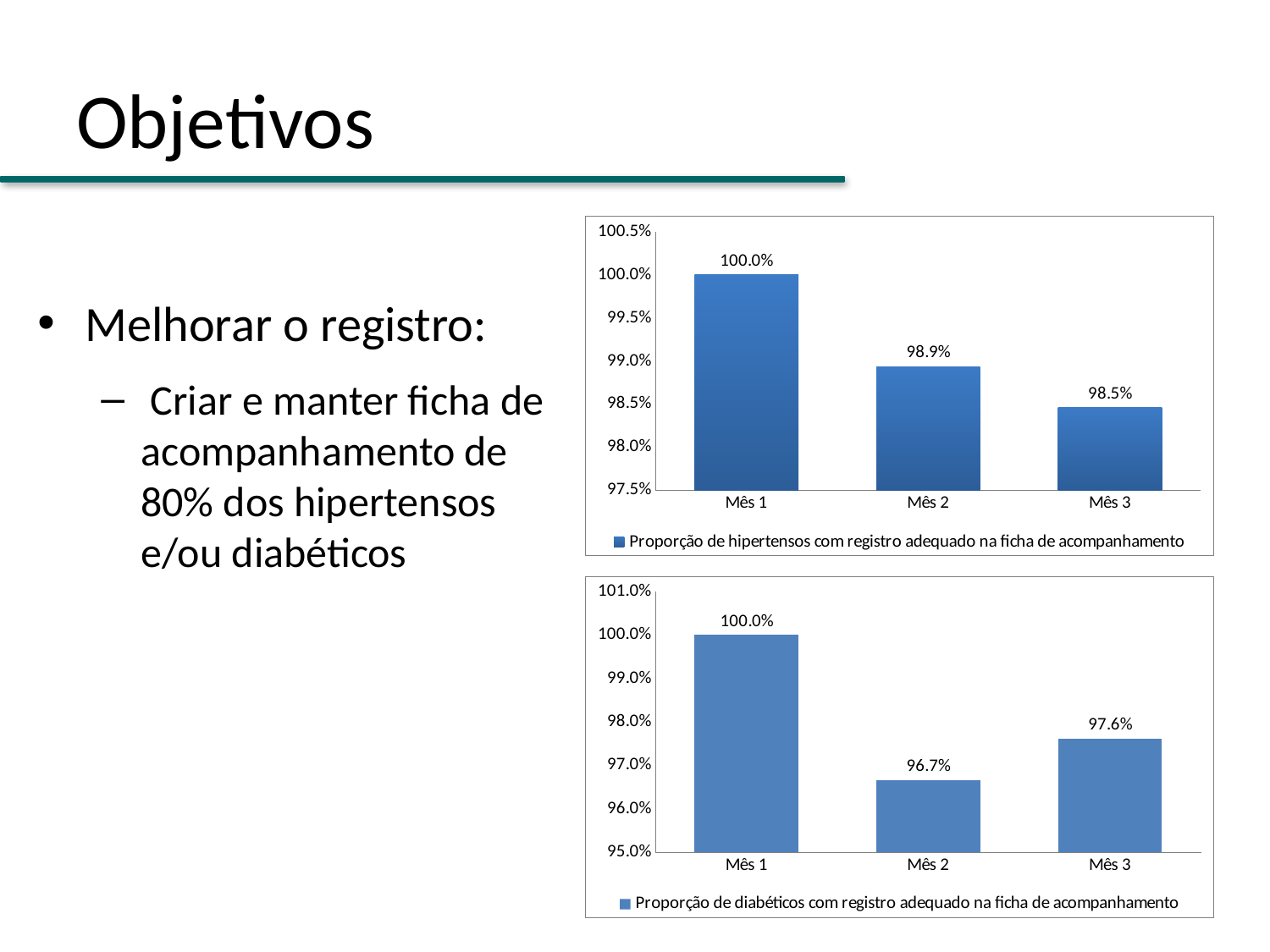
In the bottom chart (diabéticos), what is the difference between Mês 3 and Mês 2? 0.9% In the bottom chart (diabéticos), what is the value for Mês 2? 96.7% In the bottom chart (diabéticos), which is larger, Mês 2 or Mês 3? Mês 3 In the bottom chart (diabéticos), what is the value for Mês 3? 97.6% In the top chart (hipertensos), what is the value for Mês 3? 98.5% In the top chart (hipertensos), which month has the lowest value? Mês 3 In the bottom chart (diabéticos), which month has the highest value? Mês 1 What kind of chart is the bottom chart (diabéticos)? Bar chart In the top chart (hipertensos), what is the value for Mês 2? 98.9% How many months are shown on the x axis of the top chart (hipertensos)? 3 In the bottom chart (diabéticos), which month has the lowest value? Mês 2 In the top chart (hipertensos), what is the difference between Mês 1 and Mês 3? 1.5%